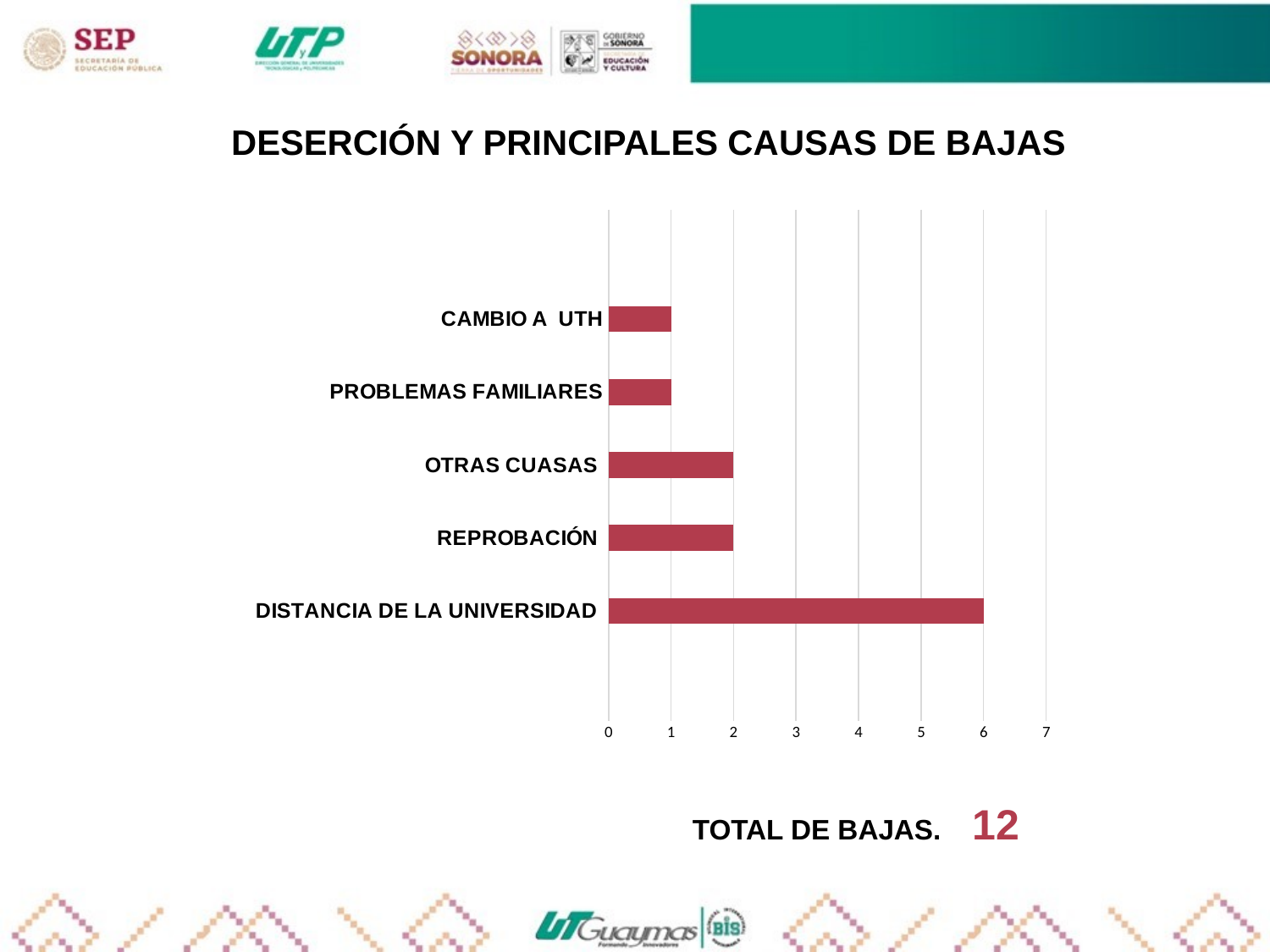
What is the value for CAMBIO A UTH? 1 What is the value for REPROBACIÓN? 2 What kind of chart is shown on the slide? bar chart Which category has the highest value? DISTANCIA DE LA UNIVERSIDAD What is the difference between the values for DISTANCIA DE LA UNIVERSIDAD and REPROBACIÓN? 4 What is the title of the slide above the chart? DESERCIÓN Y PRINCIPALES CAUSAS DE BAJAS Which is larger, the value for OTRAS CUASAS or the value for CAMBIO A UTH? OTRAS CUASAS What is the difference between the values for OTRAS CUASAS and PROBLEMAS FAMILIARES? 1 What is the value for OTRAS CUASAS? 2 What is the value for DISTANCIA DE LA UNIVERSIDAD? 6 Is the value for DISTANCIA DE LA UNIVERSIDAD greater or less than 5? greater How many categories are shown in the chart? 5